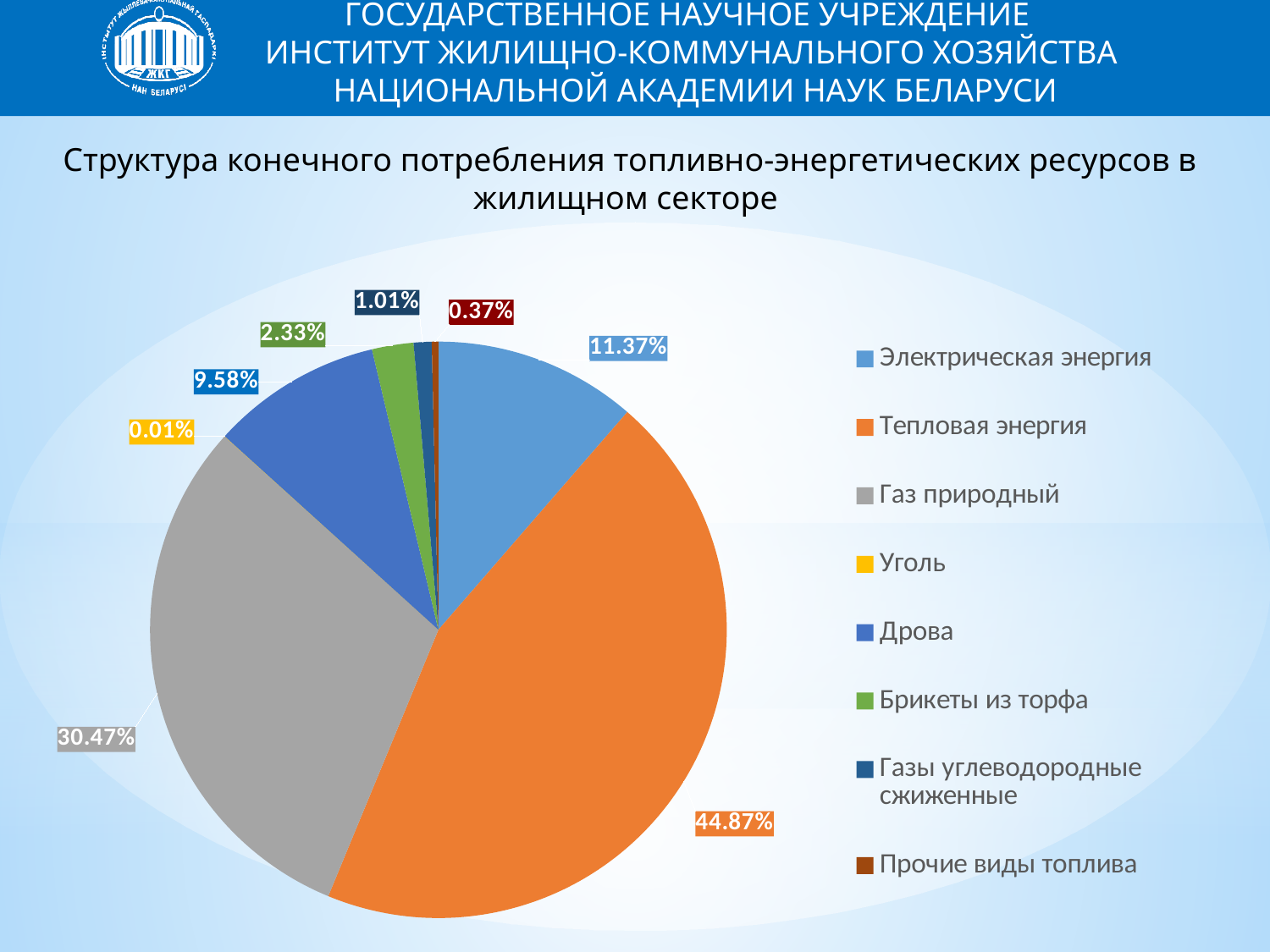
Which has a larger share, Электрическая энергия or Дрова? Электрическая энергия What share does Дрова have in the pie chart? 9.58% What share does Газ природный have in the pie chart? 30.47% What share does Тепловая энергия have in the pie chart? 44.87% How many categories does the legend of the pie chart list? 8 What is the difference between the shares of Тепловая энергия and Газ природный? 14.40% What share does Уголь have in the pie chart? 0.01% Which category has the smallest share in the pie chart? Уголь What share does Брикеты из торфа have in the pie chart? 2.33% What kind of chart is shown on the slide? Pie chart Which category has the largest share in the pie chart? Тепловая энергия What share does Электрическая энергия have in the pie chart? 11.37%